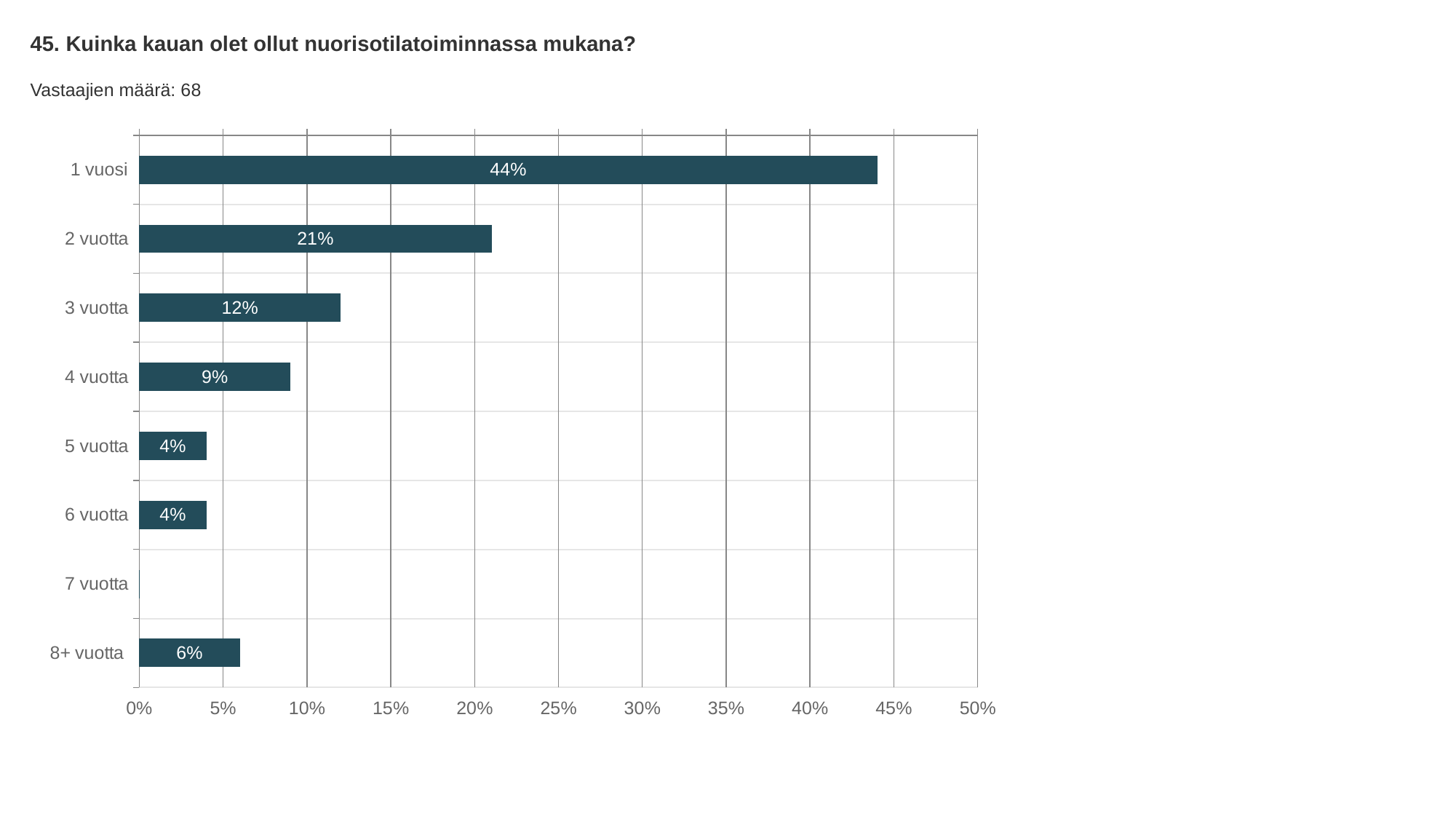
What kind of chart is shown on the slide? bar chart Which is larger, the value for "4 vuotta" or the value for "8+ vuotta"? 4 vuotta How many categories are shown on the chart? 8 Which category has the highest value? 1 vuosi What is the difference between the values for "1 vuosi" and "2 vuotta"? 23% What is the title of the chart? 45. Kuinka kauan olet ollut nuorisotilatoiminnassa mukana? Which category has the lowest value? 7 vuotta What is the value for "1 vuosi"? 44% What is the value for "3 vuotta"? 12% What is the value for "8+ vuotta"? 6% How many respondents (Vastaajien määrä) does the slide report? 68 Is the value for "2 vuotta" greater or less than 25%? less